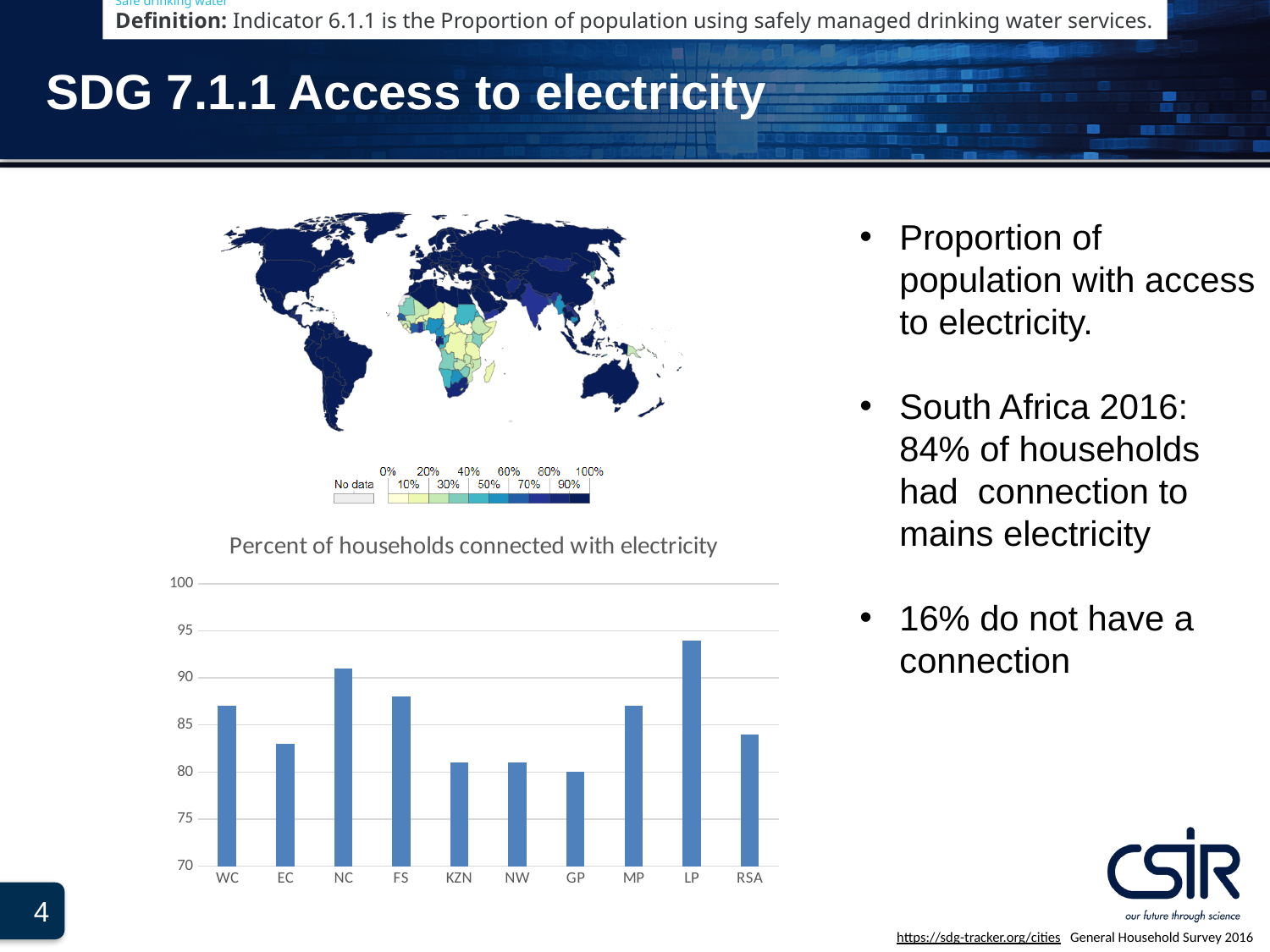
Is the value for WC greater or less than 85? greater Is the value for LP greater or less than 90? greater Is the value for NC greater or less than 90? greater What is the title of the bar chart on the slide? Percent of households connected with electricity Which category has the highest bar in the bar chart? LP Which has the larger value in the bar chart, FS or KZN? FS Which has the larger value in the bar chart, NC or EC? NC How many categories are shown on the x axis of the bar chart? 10 What kind of chart is shown below the map on the slide? bar chart